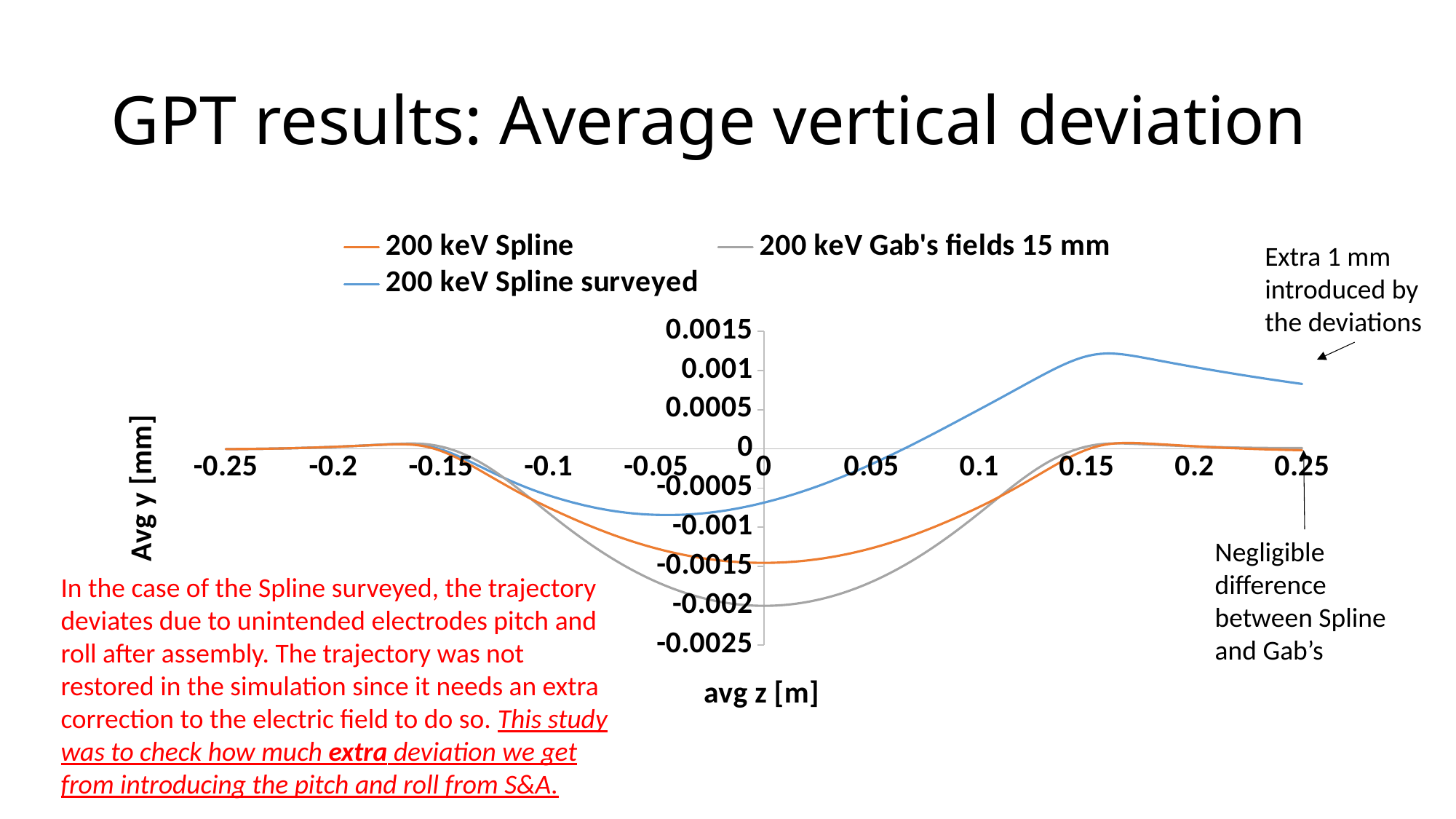
At avg z = 0.15, is the value for 200 keV Spline surveyed greater or less than 0.001? greater Which series reaches the lowest value on the chart? 200 keV Gab's fields 15 mm At avg z = 0, is the value for 200 keV Spline surveyed greater or less than -0.001? greater Does the 200 keV Spline surveyed series rise or fall between avg z = 0 and avg z = 0.15? rise How many tick labels are shown on the horizontal axis of the chart? 11 What kind of chart is shown on the slide? line chart Which series reaches the highest value on the chart? 200 keV Spline surveyed What is the title of the vertical axis of the chart? Avg y [mm] How many series does the chart legend list? 3 At avg z = 0.25, is the value for 200 keV Spline surveyed greater or less than 0.0005? greater What is the title of the horizontal axis of the chart? avg z [m] At avg z = 0, which series has the larger value: 200 keV Spline surveyed or 200 keV Gab's fields 15 mm? 200 keV Spline surveyed